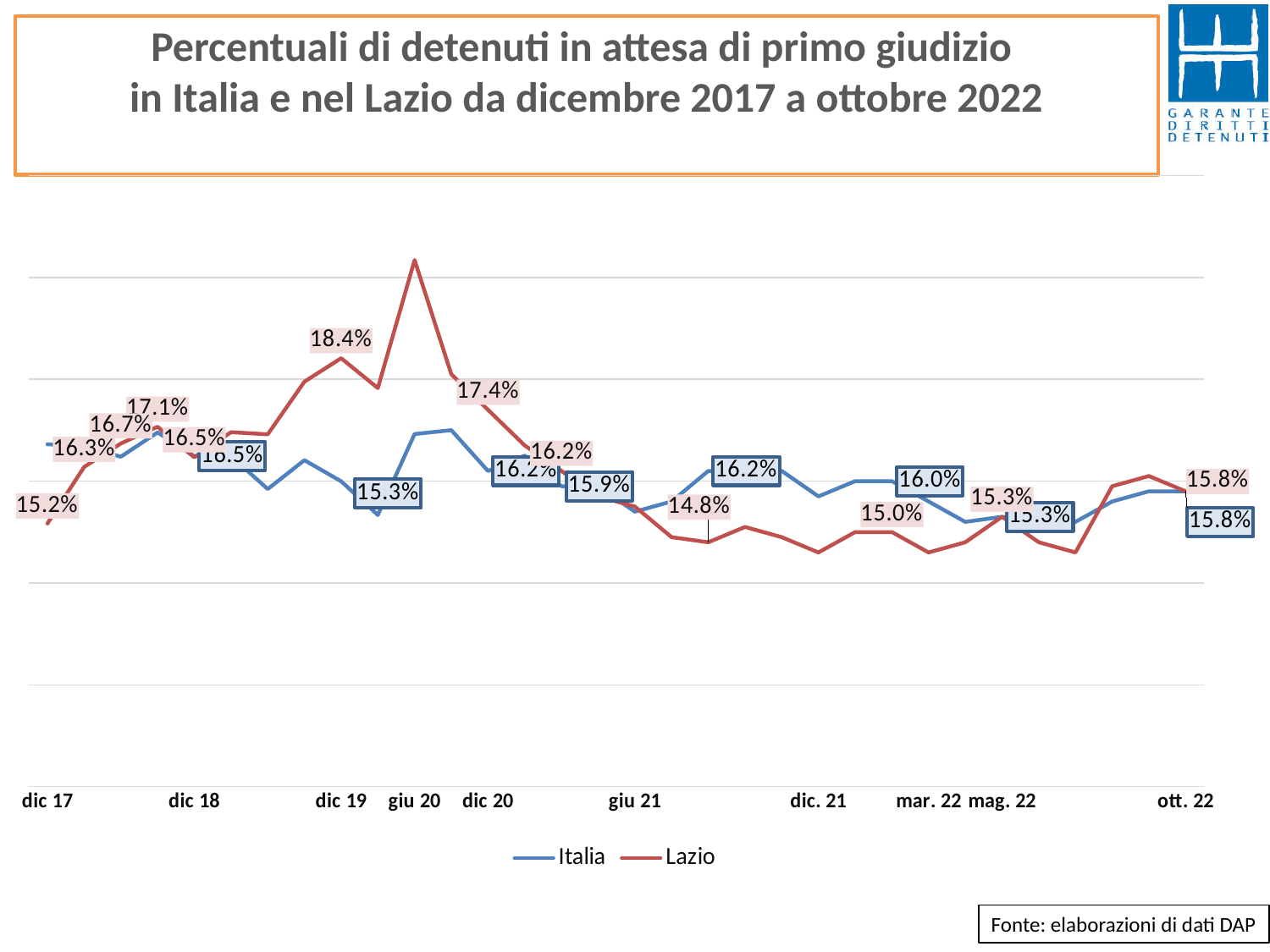
Which series reaches the highest point on the chart? Lazio How many series does the legend list? 2 What kind of chart is shown on the slide? line chart What is the value for Lazio at dic 17? 15.2% At giu 20, which series has the higher value, Italia or Lazio? Lazio What is the value for Italia at ott. 22? 15.8% How many date labels are shown on the x axis? 10 What is the value for Lazio at ott. 22? 15.8% By how many percentage points does the Lazio value at ott. 22 exceed its value at dic 17? 0.6 At dic 17, which series has the higher value, Italia or Lazio? Italia What are the two series named in the legend? Italia and Lazio